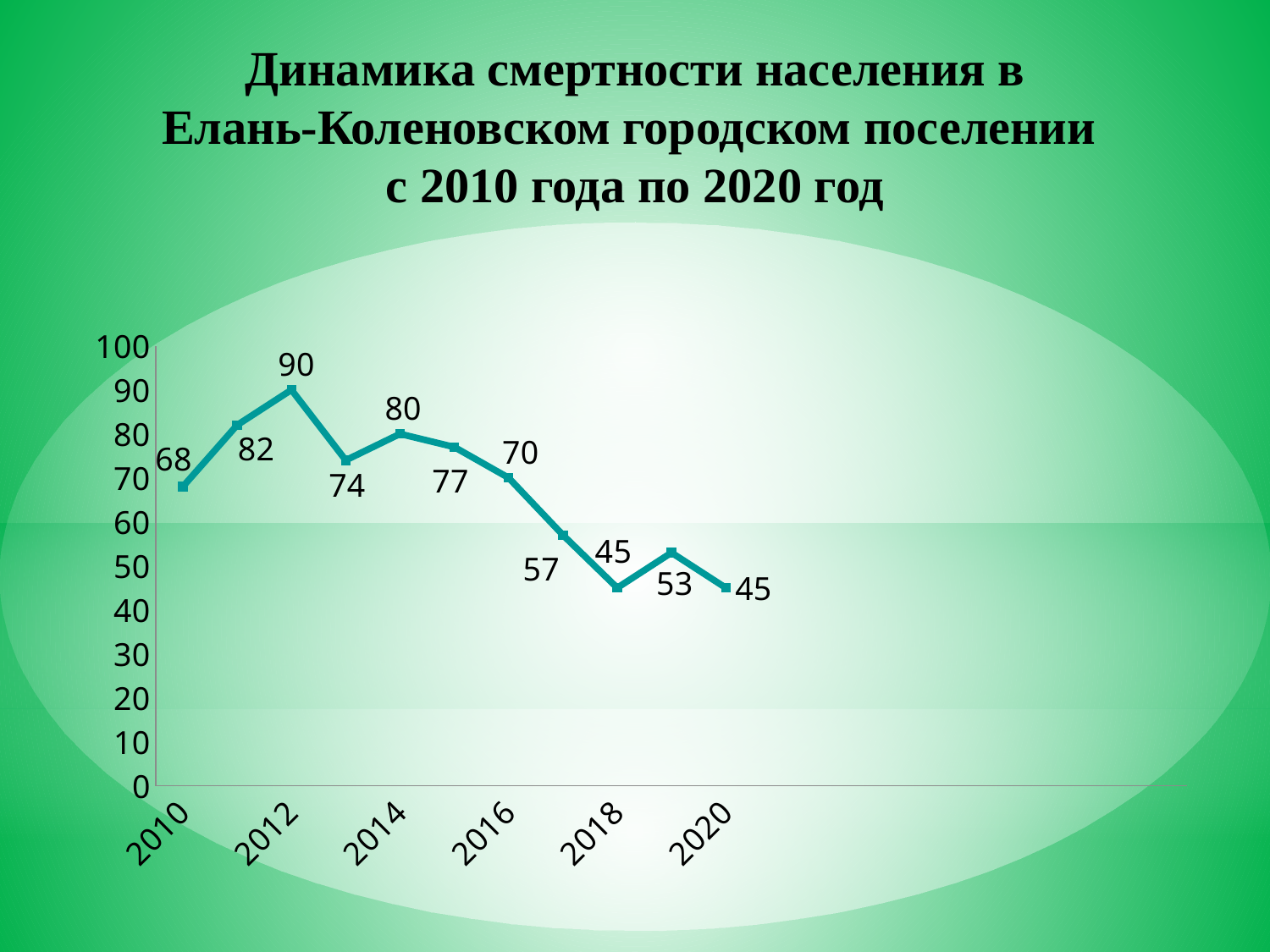
Which is larger, the value for 2014 or the value for 2016? 2014 Is the value for 2018 greater or less than 50? less How many data points are plotted on the line? 11 What is the value for 2012? 90 Do the values generally rise or fall from 2012 to 2020? fall Which year has the highest value? 2012 What is the value for 2010? 68 What is the difference between the values for 2010 and 2020? 23 What type of chart is shown on the slide? line chart What is the lowest value plotted on the chart? 45 What is the value for 2020? 45 What is the value for 2016? 70